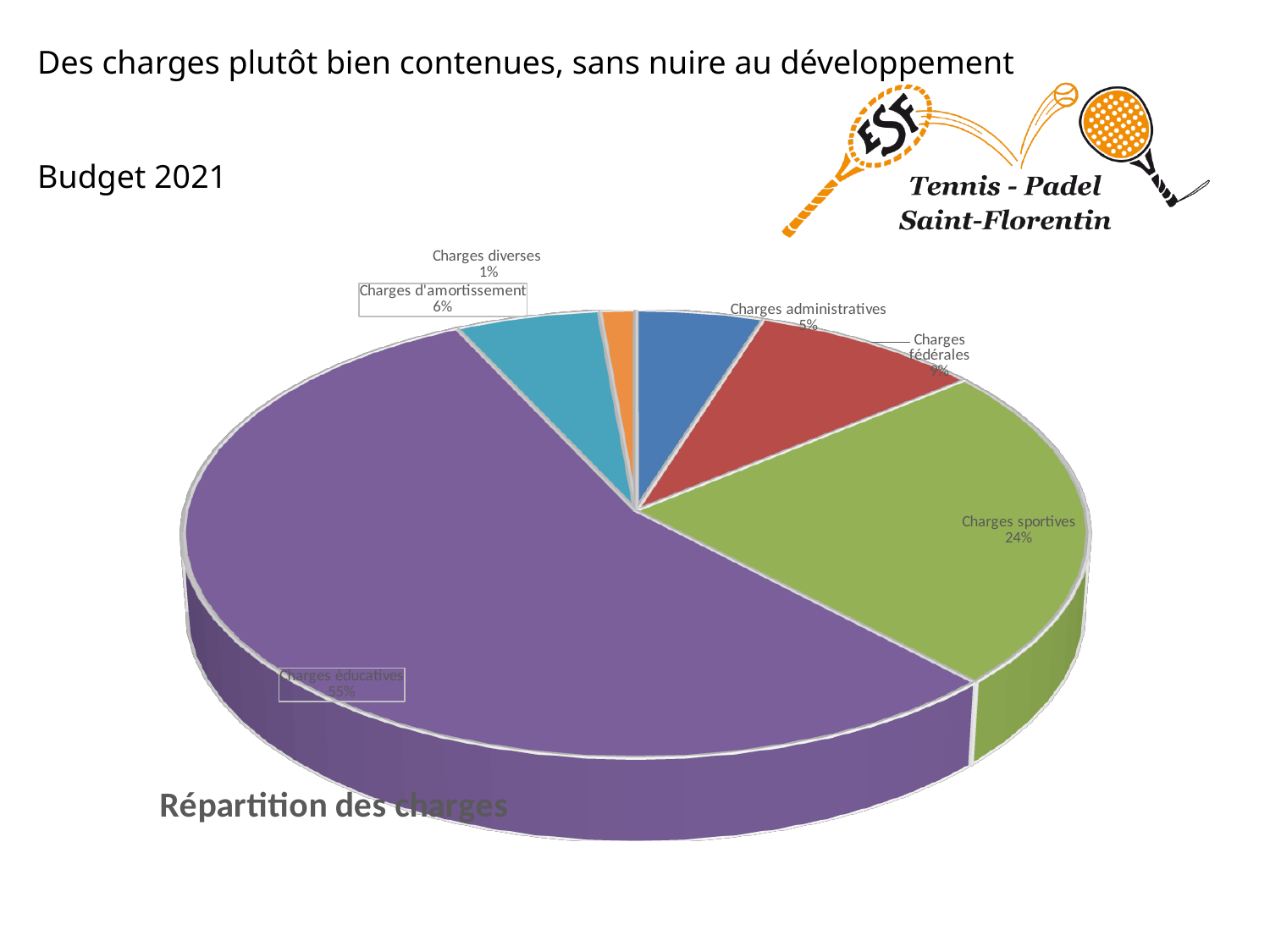
How many categories are shown in the pie chart? 6 What percentage of the pie is Charges sportives? 24% What is the title of the chart? Répartition des charges What percentage of the pie is Charges administratives? 5% Which is larger, Charges d'amortissement or Charges administratives? Charges d'amortissement What percentage of the pie is Charges diverses? 1% What is the difference in percentage points between Charges éducatives and Charges sportives? 31 percentage points Which category has the smallest slice of the pie? Charges diverses What percentage of the pie is Charges d'amortissement? 6% What kind of chart is shown on the slide? pie chart Which category has the largest slice of the pie? Charges éducatives What percentage of the pie is Charges éducatives? 55%